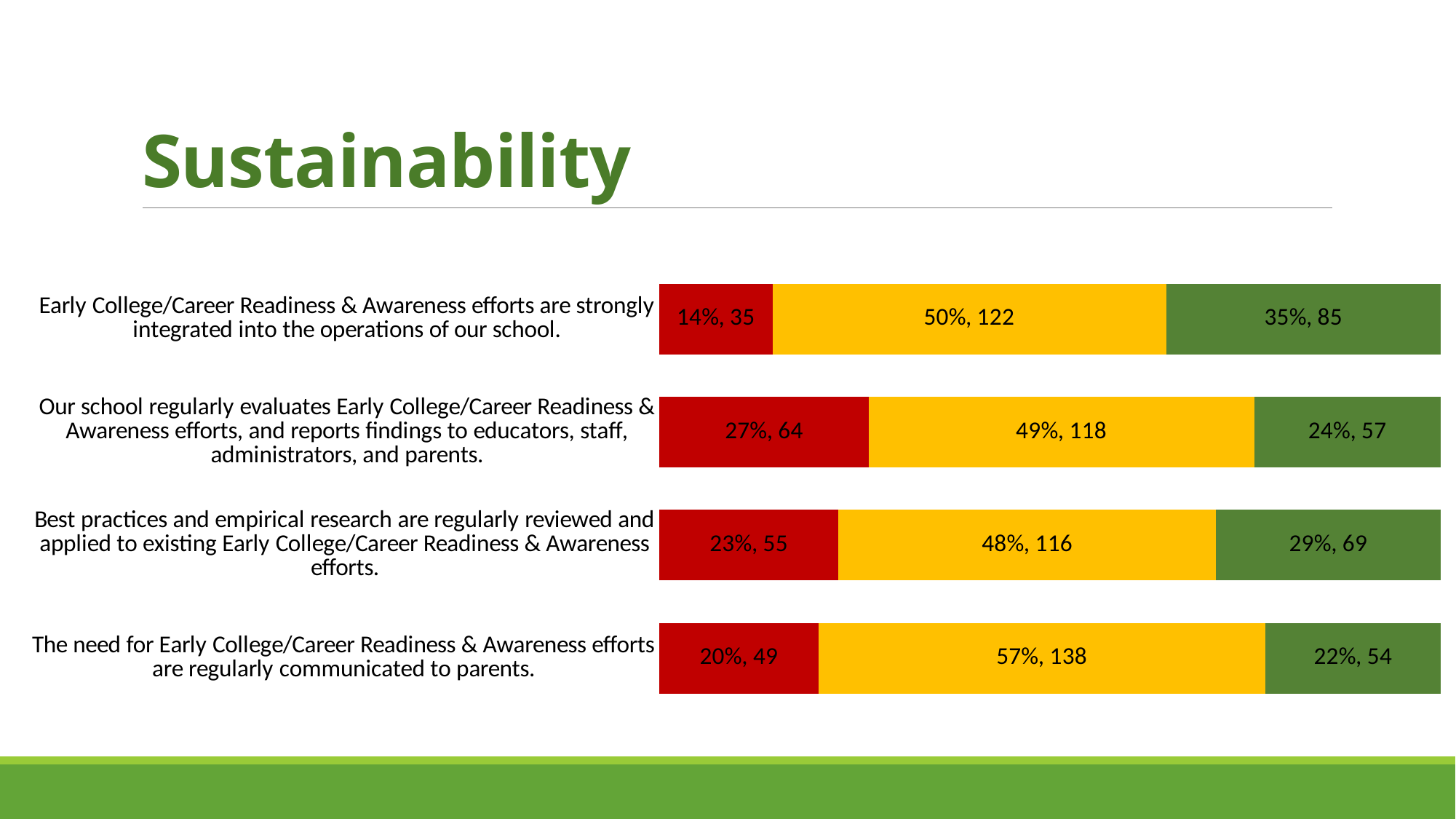
Which has the larger red segment count: "Our school regularly evaluates Early College/Career Readiness & Awareness efforts..." or "Best practices and empirical research are regularly reviewed and applied..."? Our school regularly evaluates Early College/Career Readiness & Awareness efforts, and reports findings to educators, staff, administrators, and parents. What is the title of the slide? Sustainability What is the total number of respondents across all three segments for "Early College/Career Readiness & Awareness efforts are strongly integrated into the operations of our school."? 242 How many more respondents are in the green segment for "Early College/Career Readiness & Awareness efforts are strongly integrated into the operations of our school." (85) than in the green segment for "Our school regularly evaluates..." (57)? 28 How many survey statements (categories) are plotted in the chart? 4 Which statement has the smallest red segment? Early College/Career Readiness & Awareness efforts are strongly integrated into the operations of our school. What kind of chart is shown on the slide? Stacked bar chart Which statement has the largest yellow segment? The need for Early College/Career Readiness & Awareness efforts are regularly communicated to parents. What is the data label on the green segment for "Our school regularly evaluates Early College/Career Readiness & Awareness efforts, and reports findings to educators, staff, administrators, and parents."? 24%, 57 What is the data label on the red segment for "Early College/Career Readiness & Awareness efforts are strongly integrated into the operations of our school."? 14%, 35 How many coloured segments make up each bar in the chart? 3 What is the data label on the yellow segment for "The need for Early College/Career Readiness & Awareness efforts are regularly communicated to parents."? 57%, 138